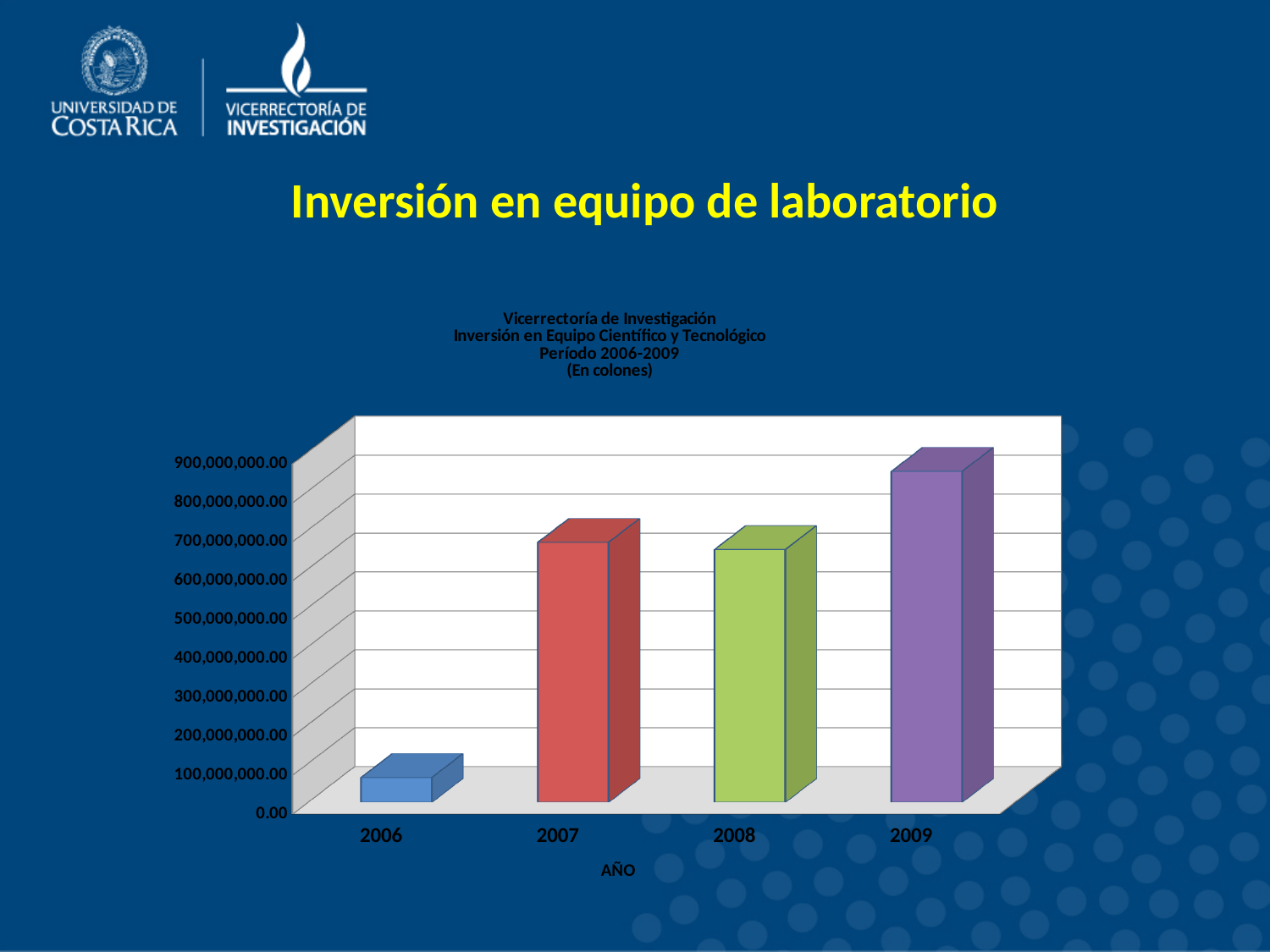
How many years are plotted on the x axis of the chart? 4 Is the value for 2007 greater or less than 600,000,000.00? greater Which year has the lowest investment in the chart? 2006 What kind of chart is shown on the slide? Bar chart In what currency are the values in the chart expressed, according to the chart title? Colones Which year has the larger investment, 2007 or 2008? 2007 Is the value for 2008 greater or less than 800,000,000.00? less What is the title of the x axis of the chart? AÑO Is the value for 2006 greater or less than 200,000,000.00? less Which year has the highest investment in the chart? 2009 Does the investment rise or fall from 2008 to 2009? Rise